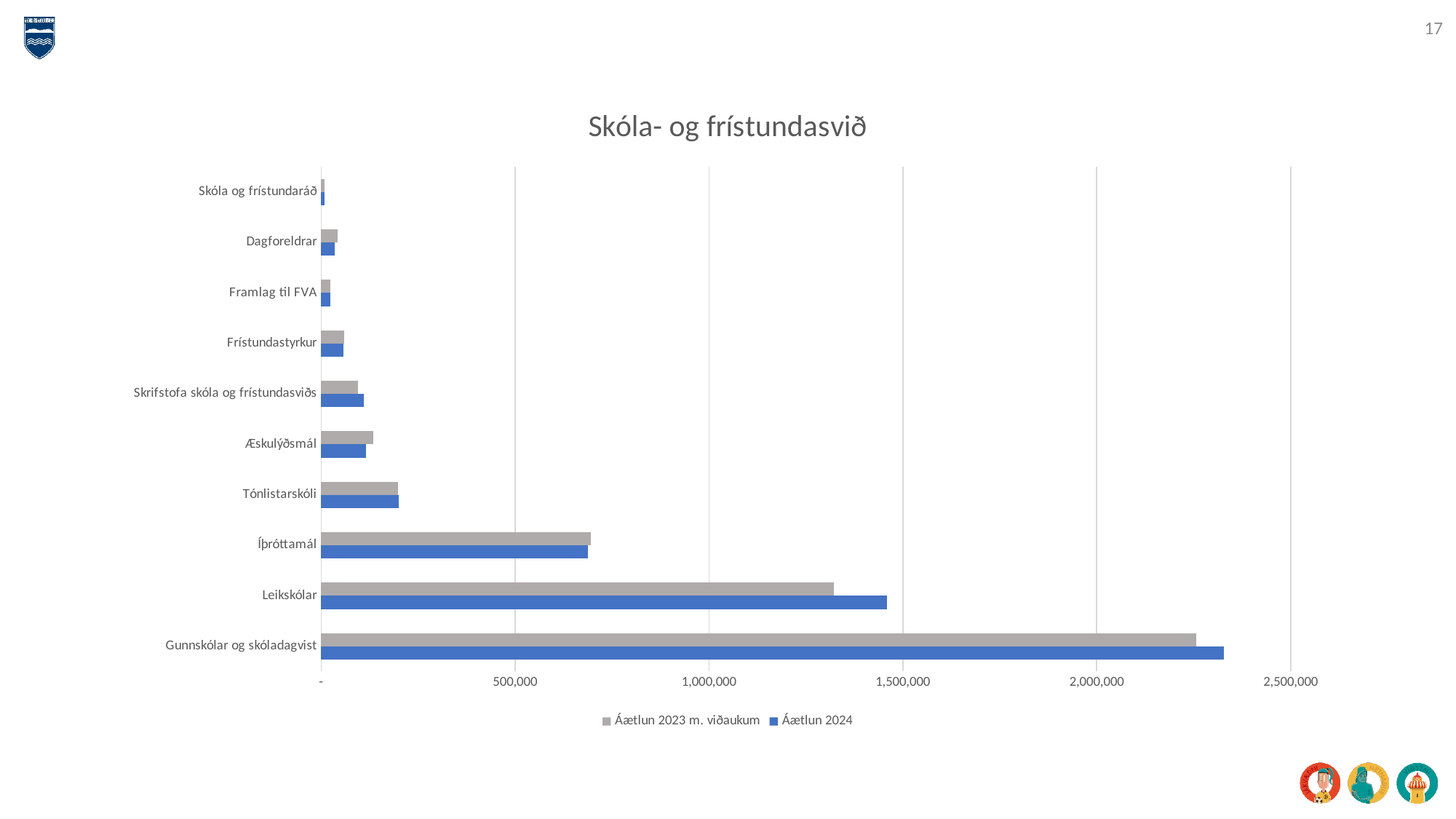
How many series does the legend list? 2 What kind of chart is shown on the slide? Bar chart Which colour represents the Áætlun 2024 series in the chart? Blue For Æskulýðsmál, which series has the larger value: Áætlun 2023 m. viðaukum or Áætlun 2024? Áætlun 2023 m. viðaukum How many categories are shown on the vertical axis of the chart? 10 Which category has the lowest value for Áætlun 2023 m. viðaukum? Skóla og frístundaráð Is the Áætlun 2024 value for Leikskólar greater or less than 1,000,000? greater Is the Áætlun 2024 value for Gunnskólar og skóladagvist greater or less than 2,000,000? greater Is the Áætlun 2023 m. viðaukum value for Tónlistarskóli greater or less than 500,000? less For Leikskólar, which series has the larger value: Áætlun 2023 m. viðaukum or Áætlun 2024? Áætlun 2024 What is the title of the chart? Skóla- og frístundasvið Which category has the highest value for Áætlun 2024? Gunnskólar og skóladagvist